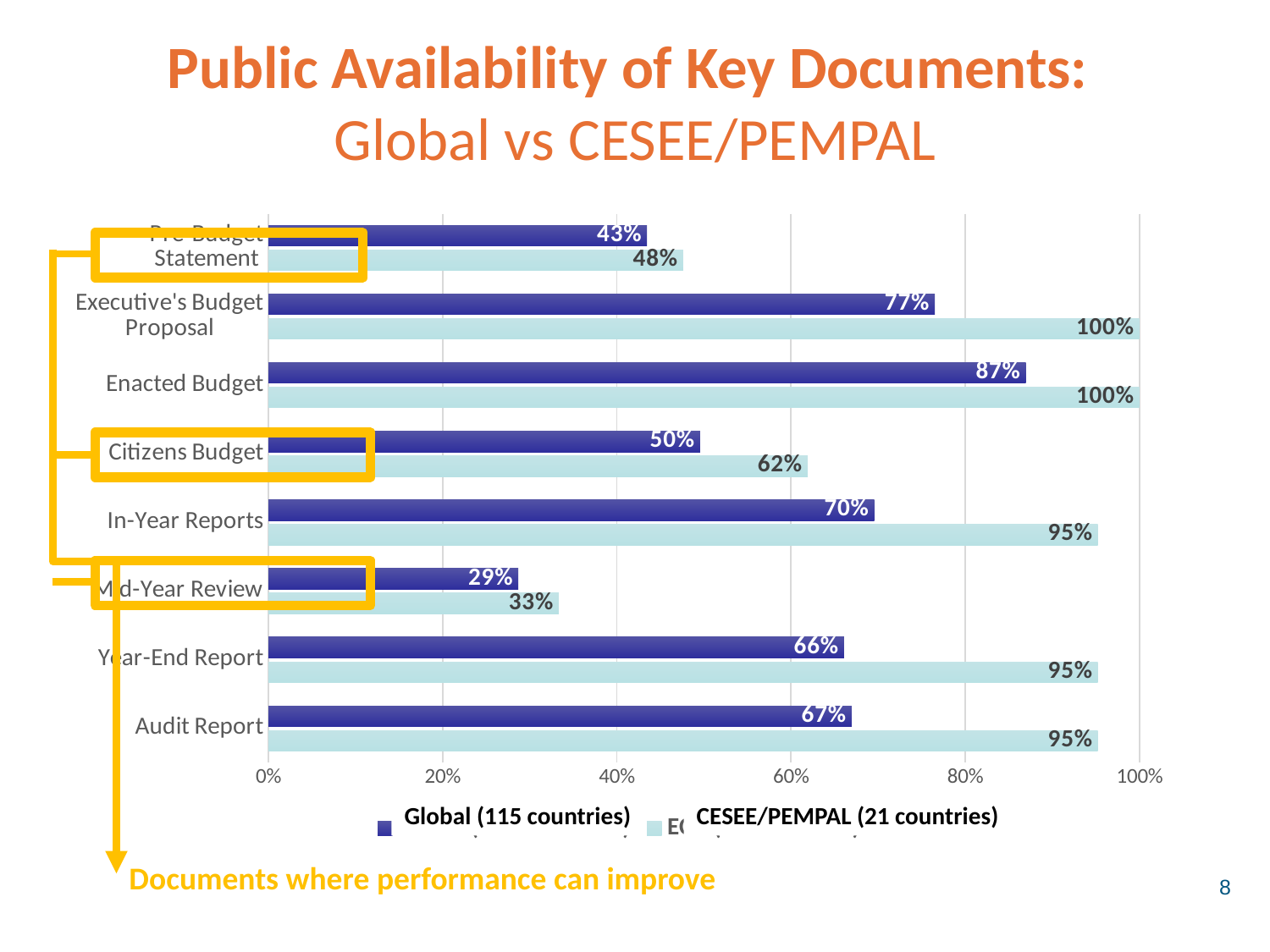
What is the CESEE/PEMPAL (21 countries) value for Citizens Budget? 62% Which document has the lowest Global (115 countries) value? Mid-Year Review Which is larger: the Global value for Year-End Report or the Global value for Audit Report? Audit Report How many series does the legend list? 2 What is the Global (115 countries) value for Audit Report? 67% What is the difference between the CESEE/PEMPAL and Global values for In-Year Reports? 25% How many countries are in the CESEE/PEMPAL group according to the legend? 21 countries How many document categories are shown on the chart? 8 What kind of chart is shown on the slide? Bar chart Which document has the highest Global (115 countries) value? Enacted Budget What is the difference between the CESEE/PEMPAL and Global values for Executive's Budget Proposal? 23% What is the Global (115 countries) value for Enacted Budget? 87%